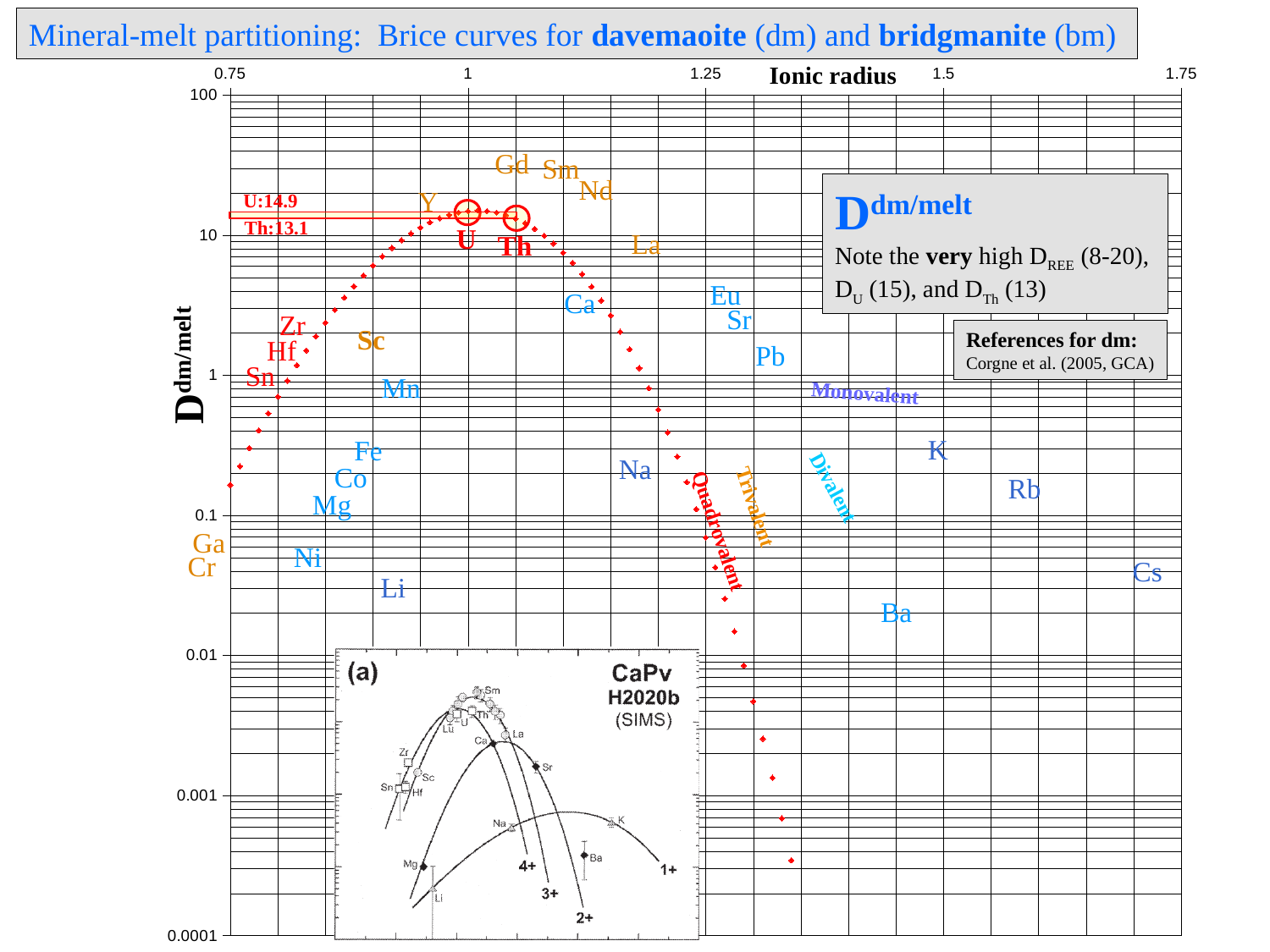
Is the value for Na greater or less than 1? less Is the value for Li greater or less than 0.1? less Is the value for Ba greater or less than 0.1? less What is the difference between the printed D values for U (14.9) and Th (13.1)? 1.8 What is the lowest value shown on the y axis? 0.0001 Do the red data points rise or fall as ionic radius increases beyond about 1.1? fall What value is printed for Th on the chart? 13.1 Which has the larger printed D value, U or Th? U What is the label of the x axis? Ionic radius What value is printed for U on the chart? 14.9